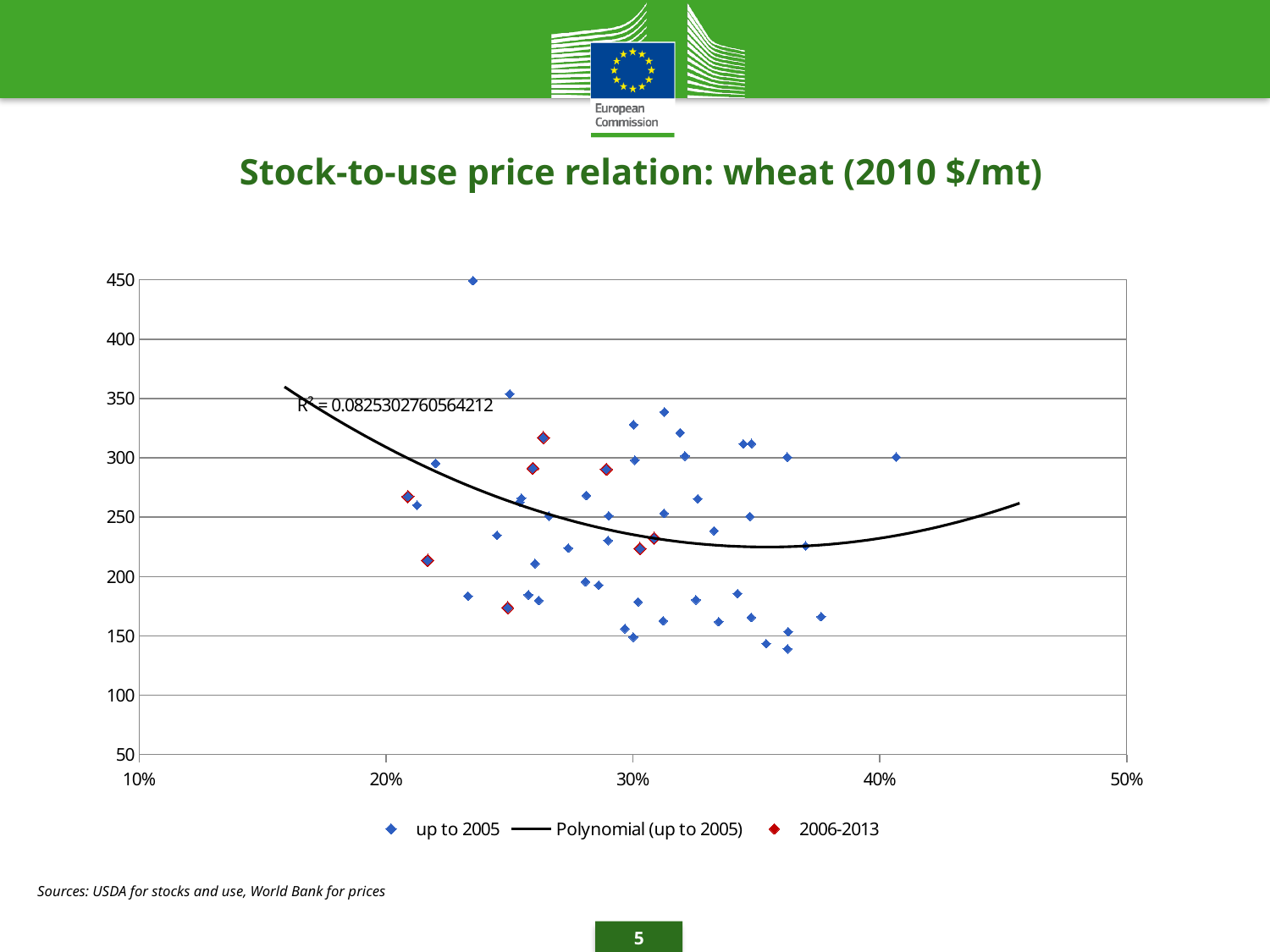
Does the polynomial trend line rise or fall as the stock-to-use ratio increases from 20% to 30%? falls What is the title of the chart? Stock-to-use price relation: wheat (2010 $/mt) What R² value is printed on the chart? 0.0825302760564212 What is the name of the series shown with red markers in the legend? 2006-2013 How many entries does the chart legend list? 3 Is the highest point in the 'up to 2005' series greater or less than 400? greater How many data points are plotted for the 2006-2013 series? 8 Is the lowest point in the 2006-2013 series greater or less than 200? less What kind of chart is shown on the slide? Scatter chart Which series has the higher maximum value, 'up to 2005' or '2006-2013'? up to 2005 Does the polynomial trend line rise or fall as the stock-to-use ratio increases from 40% to 45%? rises Is the highest point in the 2006-2013 series greater or less than 300? greater